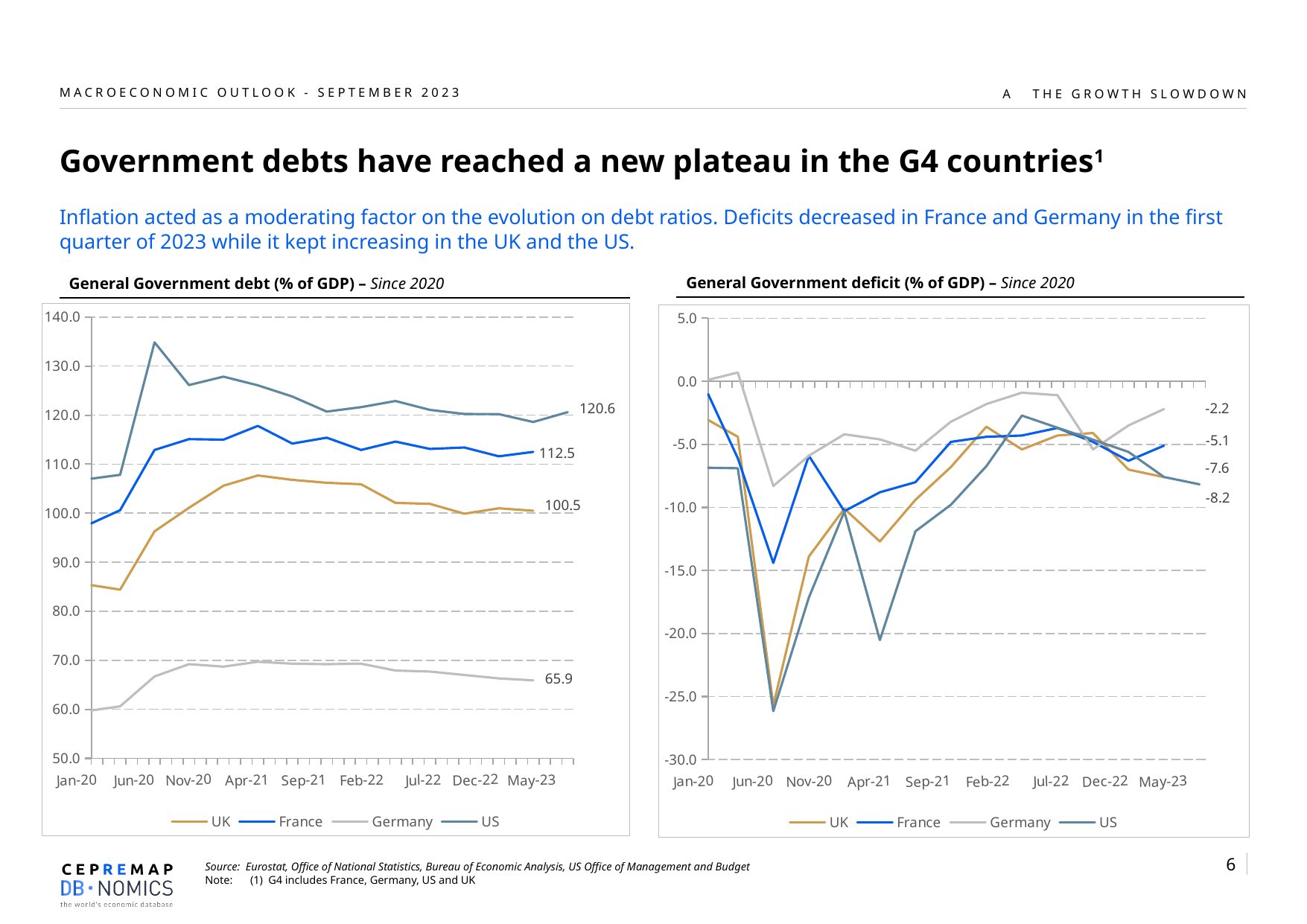
In the 'General Government debt (% of GDP)' chart, what is the difference between the latest labelled values for the US and the UK? 20.1 How many series does the legend of the 'General Government debt (% of GDP)' chart list? 4 What kind of chart is the 'General Government deficit (% of GDP)' chart? Line chart In the 'General Government deficit (% of GDP)' chart, which country has the largest deficit (lowest value) at the end of the series? US In the 'General Government deficit (% of GDP)' chart, is the latest labelled value for France greater or less than -5.1 for the UK's -7.6, i.e. which of France or the UK has the higher (less negative) latest value? France In the 'General Government debt (% of GDP)' chart, which country has the lowest debt ratio at the end of the series? Germany In the 'General Government debt (% of GDP)' chart, what is the latest labelled value for Germany? 65.9 In the 'General Government debt (% of GDP)' chart, what is the latest labelled value for the US? 120.6 In the 'General Government debt (% of GDP)' chart, what is the latest labelled value for France? 112.5 In the 'General Government deficit (% of GDP)' chart, what is the latest labelled value for Germany? -2.2 In the 'General Government deficit (% of GDP)' chart, what is the latest labelled value for the US? -8.2 In the 'General Government debt (% of GDP)' chart, is the UK's latest labelled value greater or less than 100.0? greater